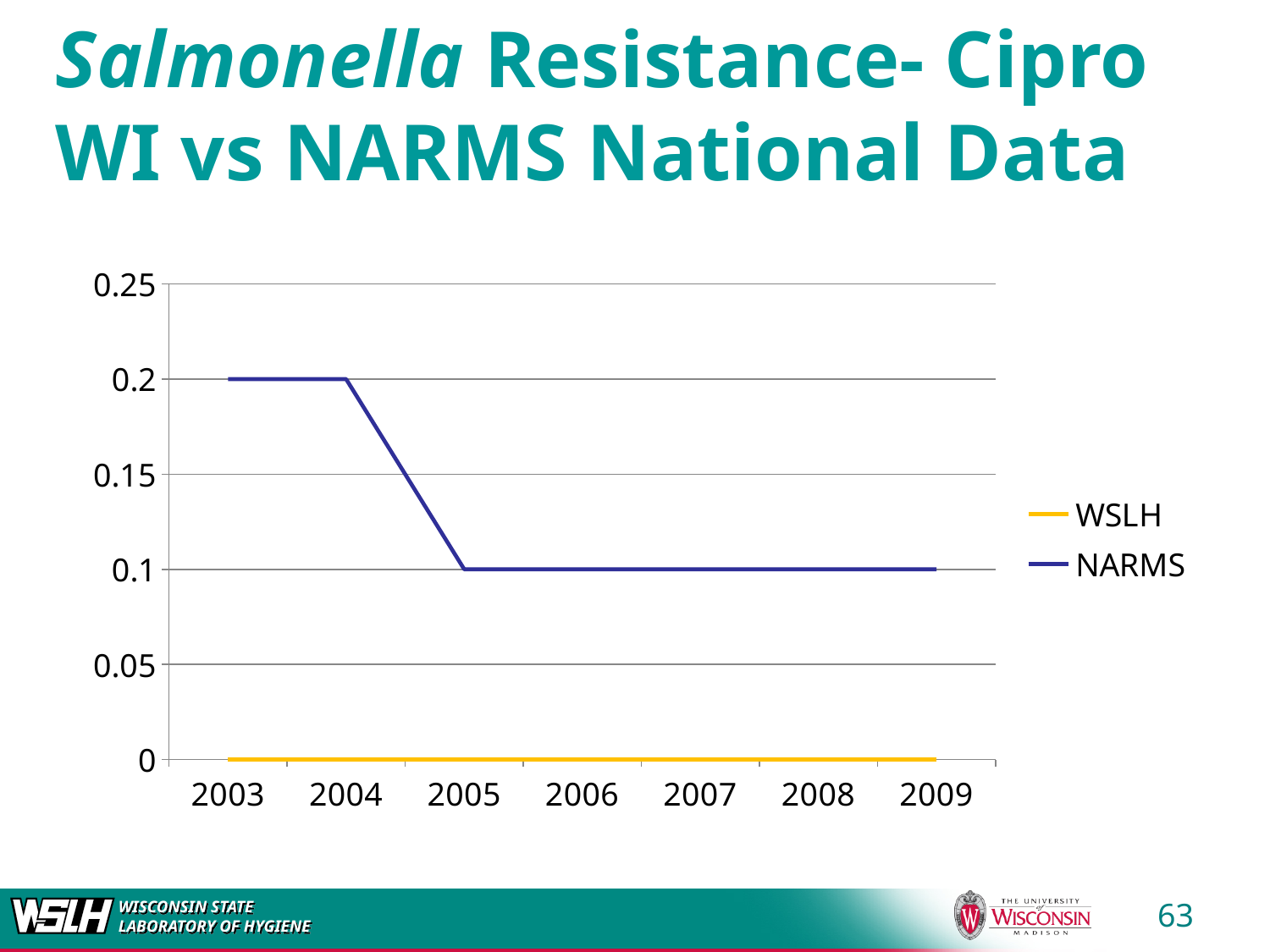
In which years does the NARMS series reach its highest value? 2003 and 2004 Which series is drawn in yellow? WSLH Which series has the larger value in 2009, WSLH or NARMS? NARMS Does the NARMS series rise or fall between 2004 and 2005? fall What is the NARMS value in 2007? 0.1 How many series does the legend list? 2 What is the highest value shown on the y axis? 0.25 What kind of chart is shown on the slide? line chart What is the WSLH value in 2005? 0 How many years are shown on the x axis? 7 What is the NARMS value in 2003? 0.2 What is the difference between the NARMS value in 2004 and in 2005? 0.1